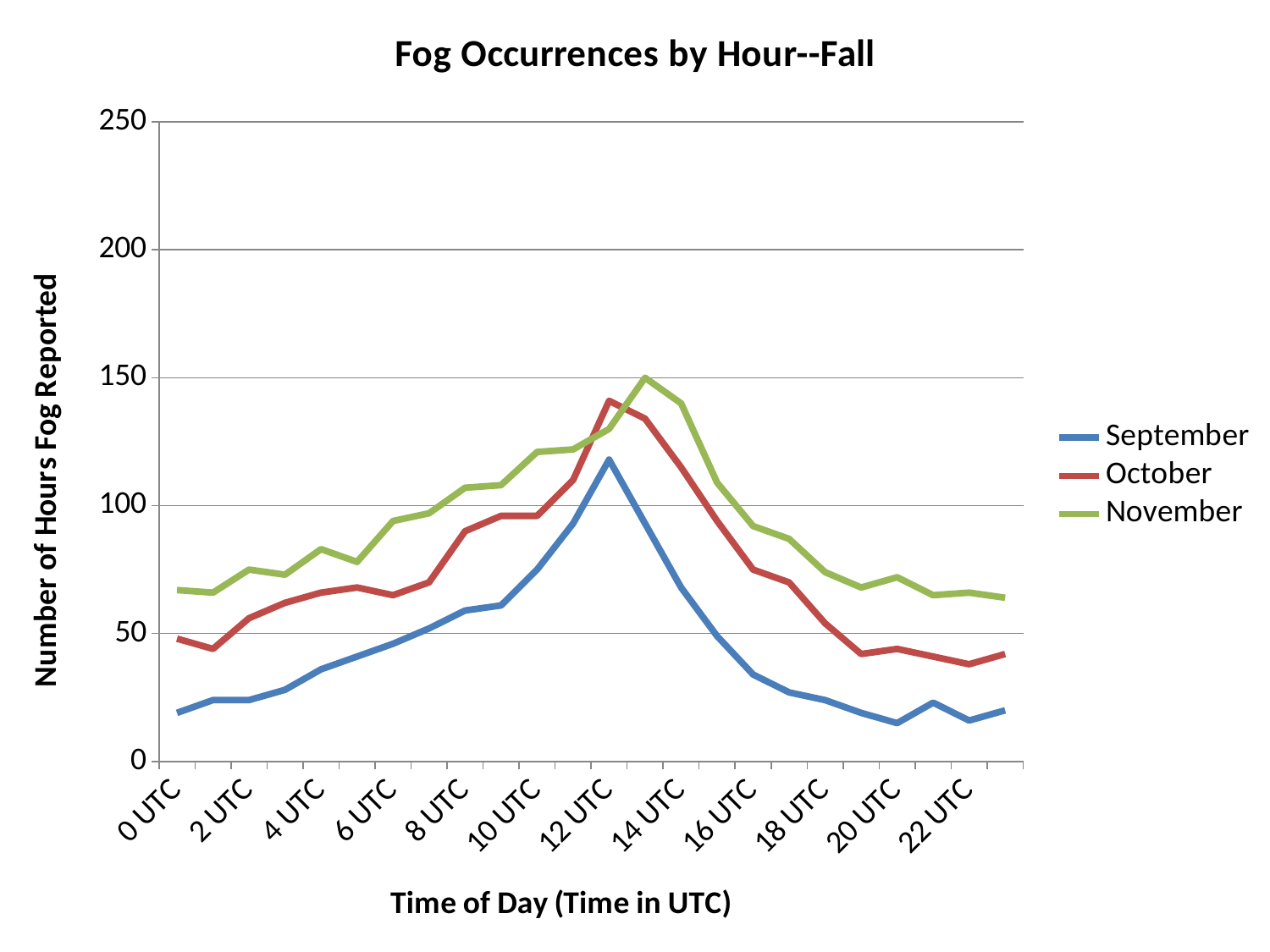
At 12 UTC, which series has the larger value, October or September? October Which series reaches the highest peak value on the chart? November Which series has the lowest values across the day? September What kind of chart is shown on the slide? Line chart Does the September series rise or fall from 0 UTC to 12 UTC? Rise Is the value for November at 0 UTC greater or less than 50? greater At which hour does the September series reach its peak? 12 UTC How many series does the legend list? 3 Is the value for October at 20 UTC greater or less than 50? less How many hour labels are shown on the x axis? 12 Is the value for September at 12 UTC greater or less than 100? greater What is the title of the chart? Fog Occurrences by Hour--Fall